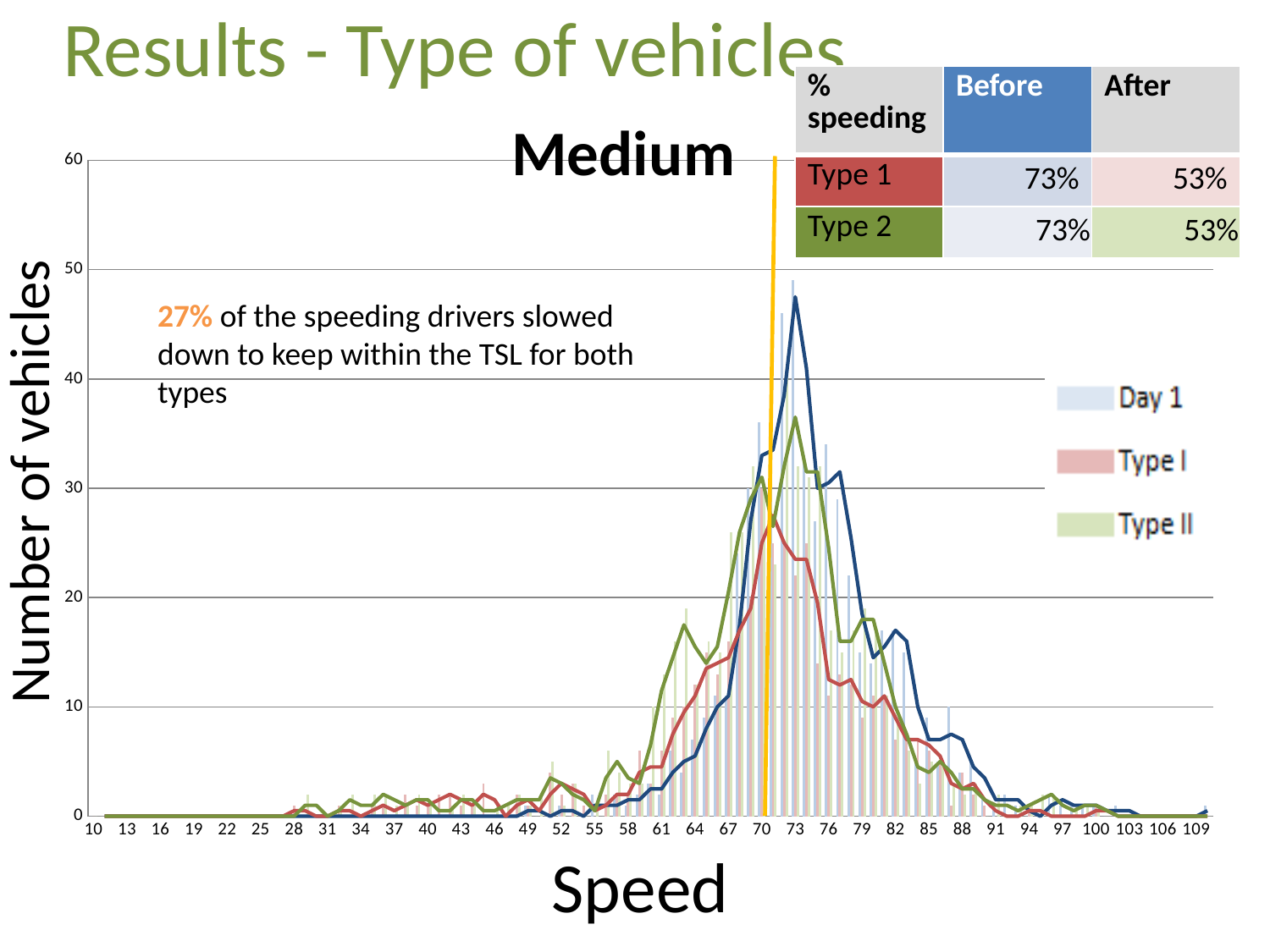
Which series reaches the highest peak value on the chart? Day 1 Is the peak value of the Type II line greater or less than 30? greater How many series does the chart legend list? 3 At speed 73, which is larger, the Day 1 value or the Type I value? Day 1 Does the Day 1 line rise or fall between speed 73 and speed 91? fall Is the Day 1 value at speed 64 greater or less than 10? less What is the title of the chart? Medium Is the Type II value at speed 64 greater or less than 10? greater Which series has the lowest peak value on the chart? Type I What is the label on the vertical axis of the chart? Number of vehicles